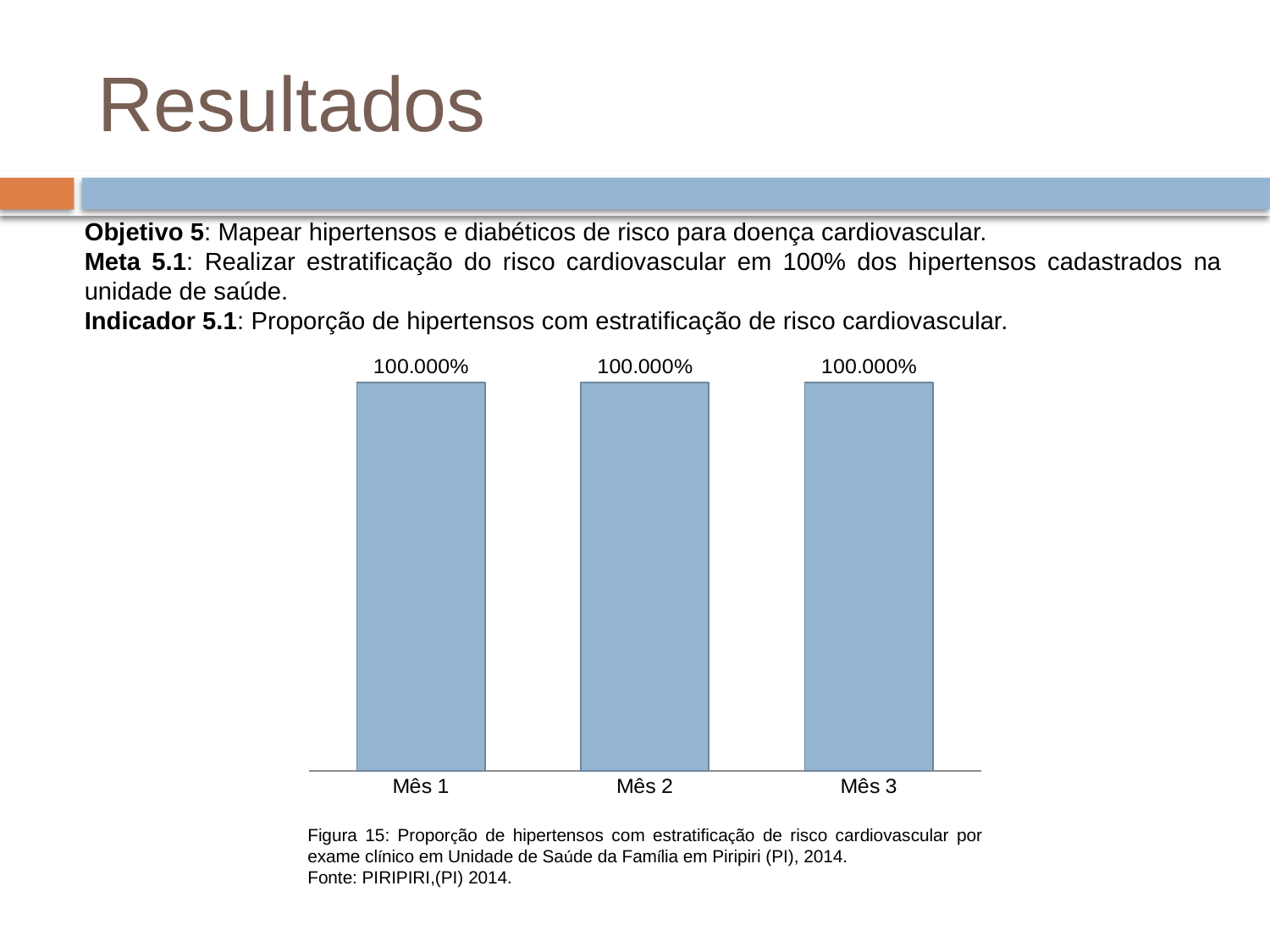
What is the figure number given in the caption below the chart? Figura 15 What kind of chart is shown on the slide? bar chart Do the values rise, fall or stay the same from Mês 1 to Mês 3? stay the same What colour are the bars in the chart? blue What is the difference between the values for Mês 1 and Mês 3? 0.000% What is the value for Mês 3? 100.000% What is the value for Mês 2? 100.000% What is the value for Mês 1? 100.000% How many categories are shown on the x axis of the chart? 3 Is the value for Mês 2 greater or less than 50%? greater